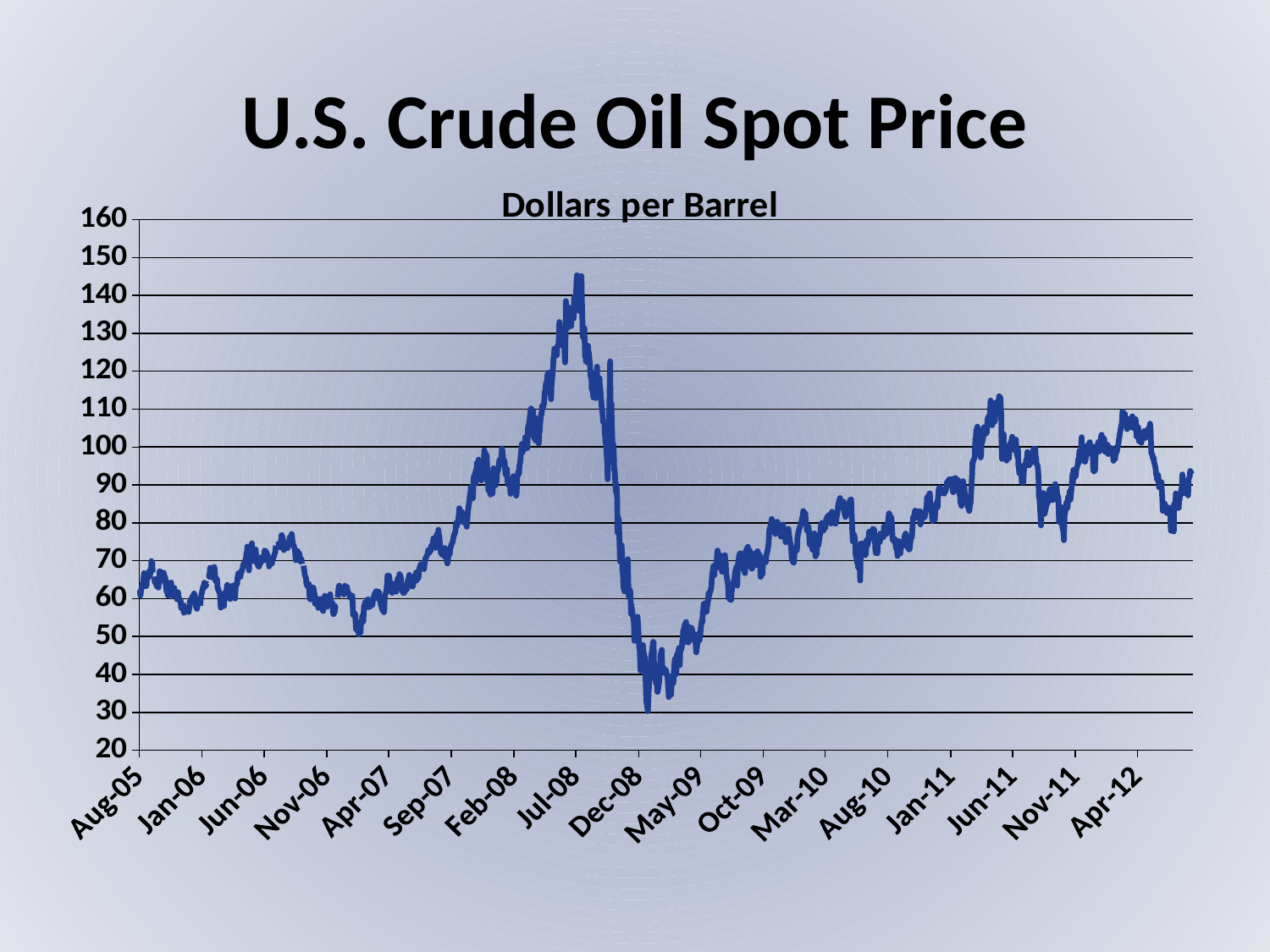
What is the title of the chart? U.S. Crude Oil Spot Price Is the price at Aug-05 greater or less than 50? greater What unit is the price measured in, according to the chart subtitle? Dollars per Barrel Is the lowest price reached shortly after Dec-08 greater or less than 40? less What kind of chart is shown on the slide? line chart Around which x-axis label does the crude oil price reach its lowest point? Dec-08 Is the price around Apr-12 greater or less than 90? greater Which is higher, the price around Jun-11 or the price around Jan-06? Jun-11 Around which x-axis label does the crude oil price reach its highest point? Jul-08 Does the price rise or fall between Jul-08 and Dec-08? fall How many date labels are shown on the x axis? 17